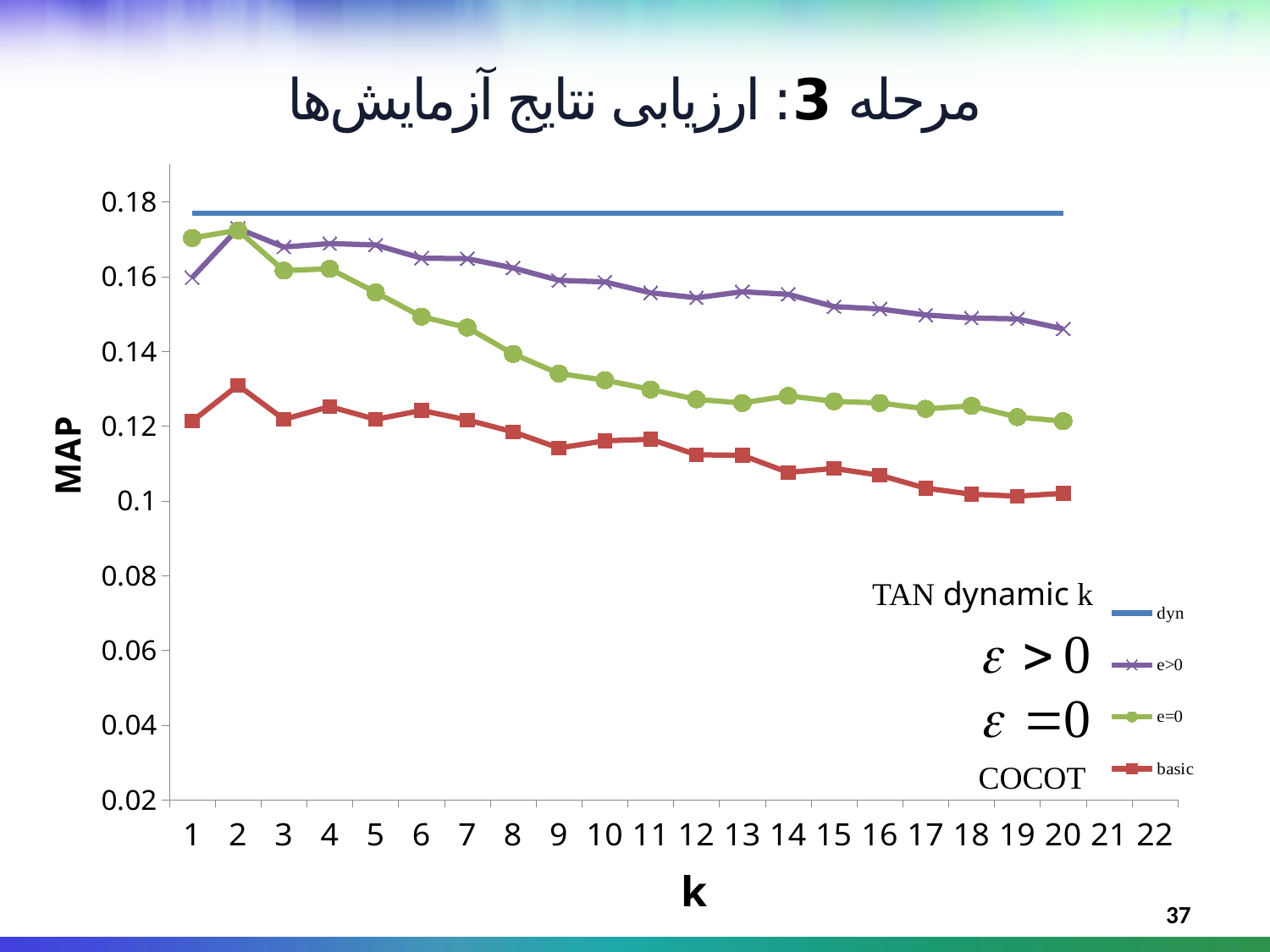
What are the series names listed in the legend? dyn, e>0, e=0, basic Which series has the highest MAP values across all k? dyn Is the MAP value of the dyn series greater or less than 0.16? greater At k=20, which series has the larger MAP value, e>0 or e=0? e>0 What kind of chart is shown on the slide? line chart Which series has the lowest MAP values across all k? basic Is the MAP value for the e=0 series at k=1 greater or less than 0.16? greater Is the MAP value for the basic series at k=20 greater or less than 0.12? less Does the MAP of the e=0 series rise or fall as k increases from 2 to 20? fall What are the labels of the x axis and the y axis? k and MAP How many series does the legend list? 4 Does the MAP of the basic series rise or fall as k increases from 2 to 20? fall